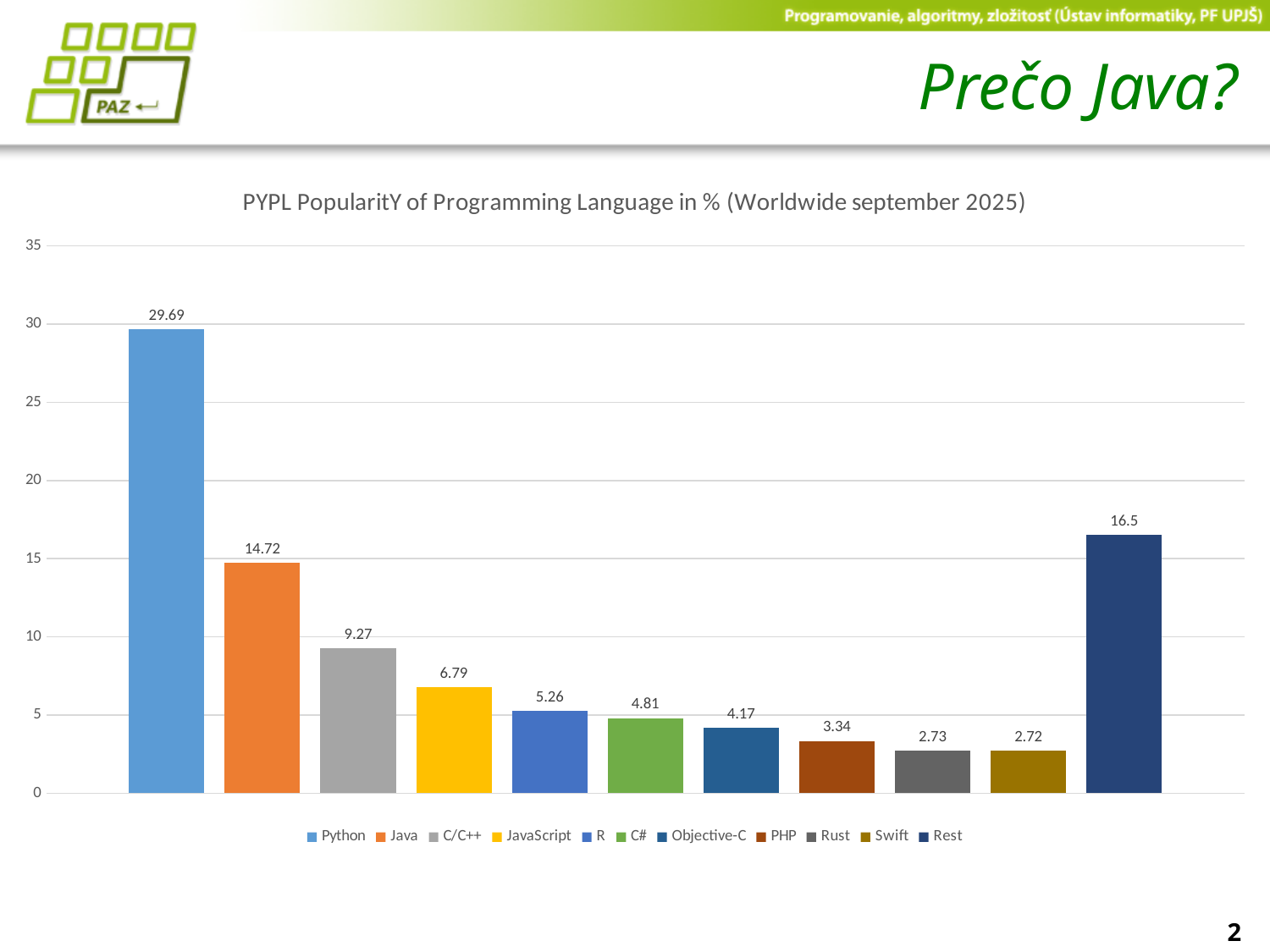
What is the difference between the values for Java and C/C++? 5.45 Is the value for C# greater or less than 5? less Which is larger, the value for Java or the value for Rest? Rest What is the value shown for Objective-C? 4.17 Which language has the highest value in the chart? Python What is the value shown for Java? 14.72 What is the title of the chart? PYPL PopularitY of Programming Language in % (Worldwide september 2025) What is the value shown for Python? 29.69 What is the difference between the values for Python and Java? 14.97 What is the value shown for the Rest bar? 16.5 How many bars are plotted in the chart? 11 What kind of chart is shown on the slide? bar chart